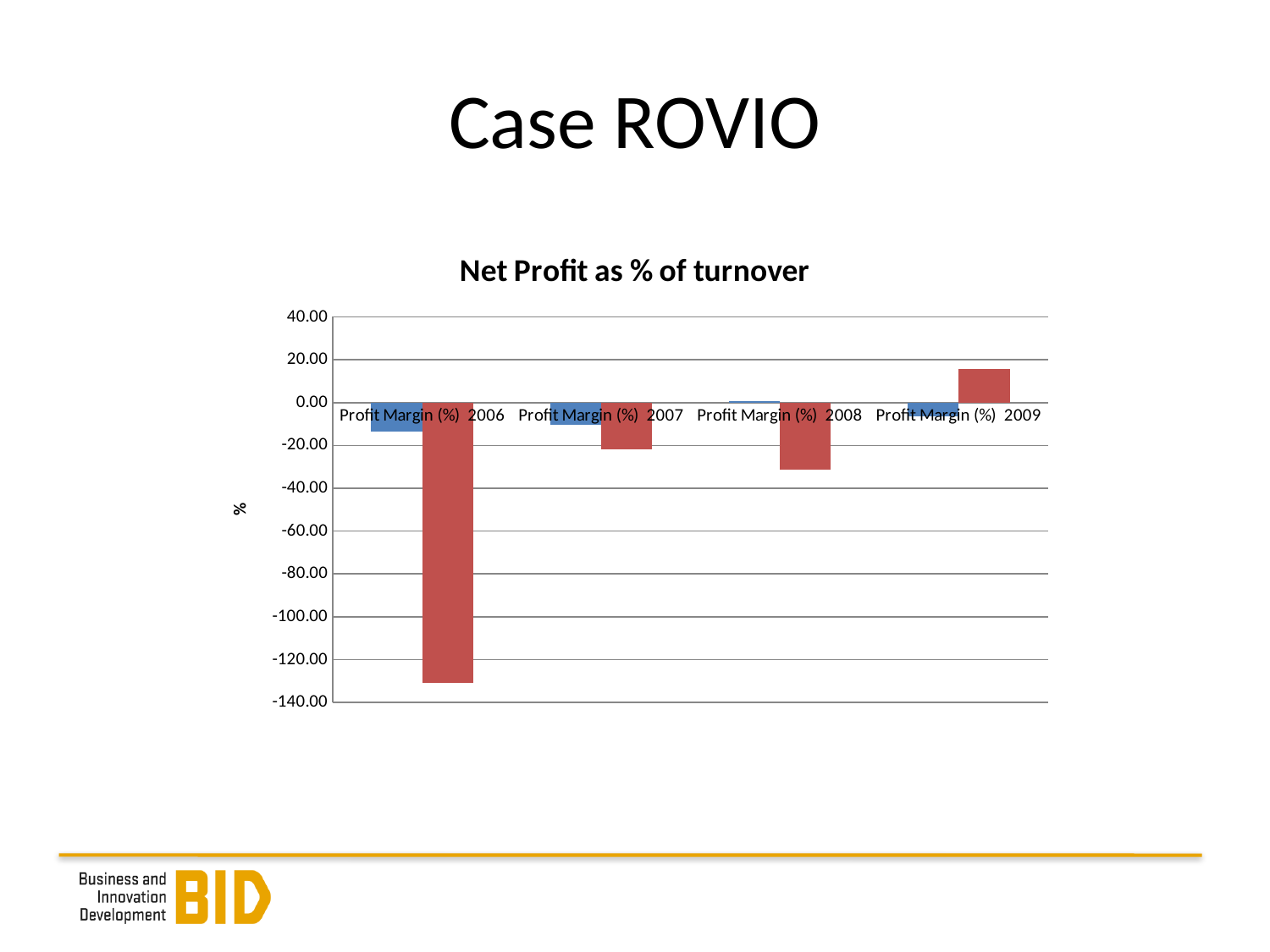
Is the red bar for Profit Margin (%) 2006 greater or less than -120? less What is the title of the chart? Net Profit as % of turnover Is the red bar for Profit Margin (%) 2009 greater or less than 20? less Which is larger, the red bar for Profit Margin (%) 2007 or the red bar for Profit Margin (%) 2008? Profit Margin (%) 2007 Which category has the lowest red bar in the chart? Profit Margin (%) 2006 What kind of chart is shown on the slide? bar chart Is the red bar for Profit Margin (%) 2009 greater or less than 0? greater How many categories are shown along the x axis of the chart? 4 Which is larger, the red bar for Profit Margin (%) 2006 or the red bar for Profit Margin (%) 2009? Profit Margin (%) 2009 Which category has the highest red bar in the chart? Profit Margin (%) 2009 What is the label on the vertical axis of the chart? %